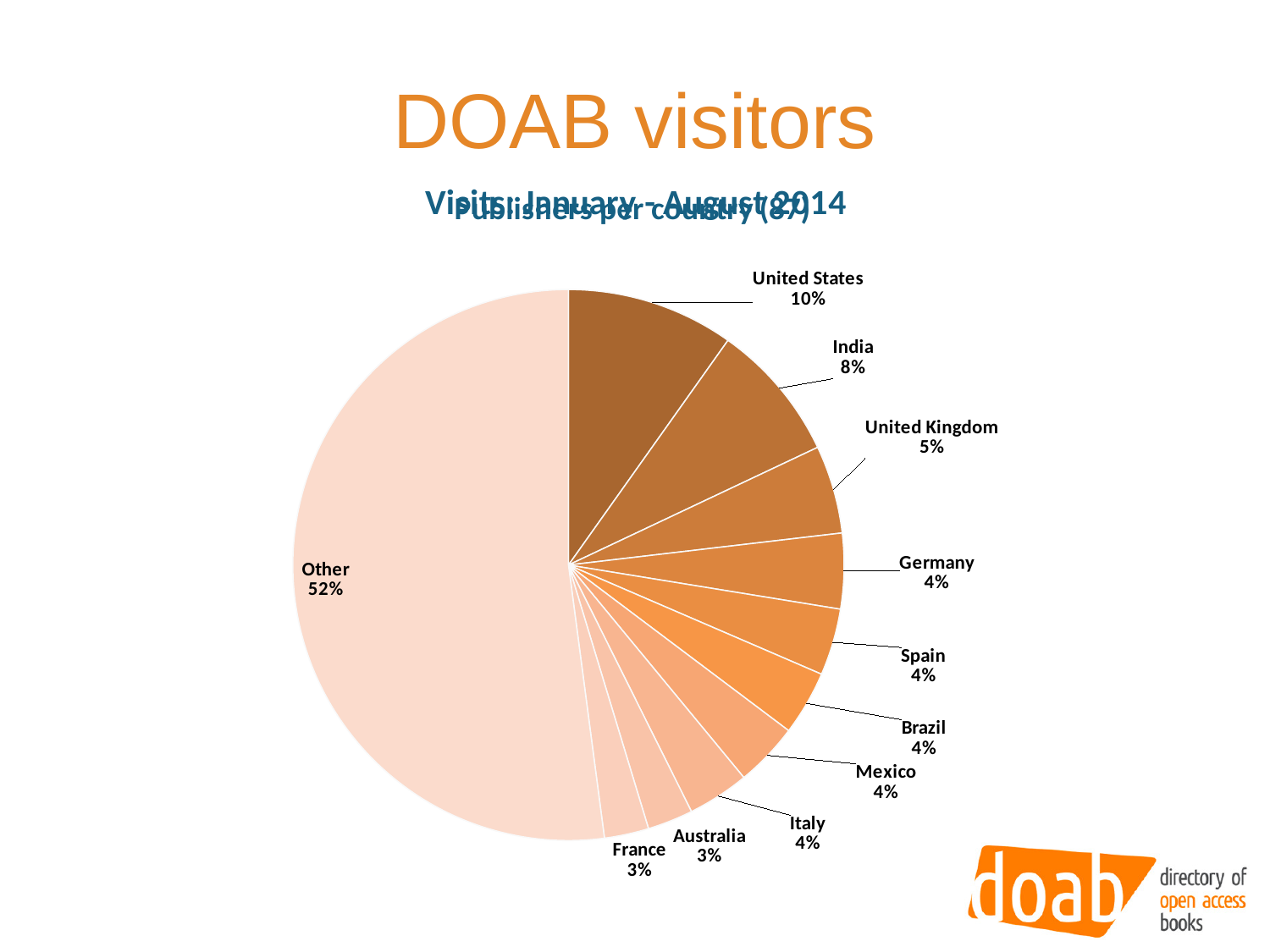
Which is larger, the slice for India or the slice for the United Kingdom? India What is the difference in percentage points between the Other slice and the United States slice? 42 What kind of chart is shown on the slide? pie chart What is the value shown for India? 8% How many slices does the pie chart have? 11 What is the value shown for Australia? 3% What is the value shown for Other? 52% Which is larger, the slice for the United States or the slice for India? United States Which slice of the pie is the largest? Other What is the value shown for the United Kingdom? 5% What is the value shown for Germany? 4% What share of the pie does the United States slice represent? 10%